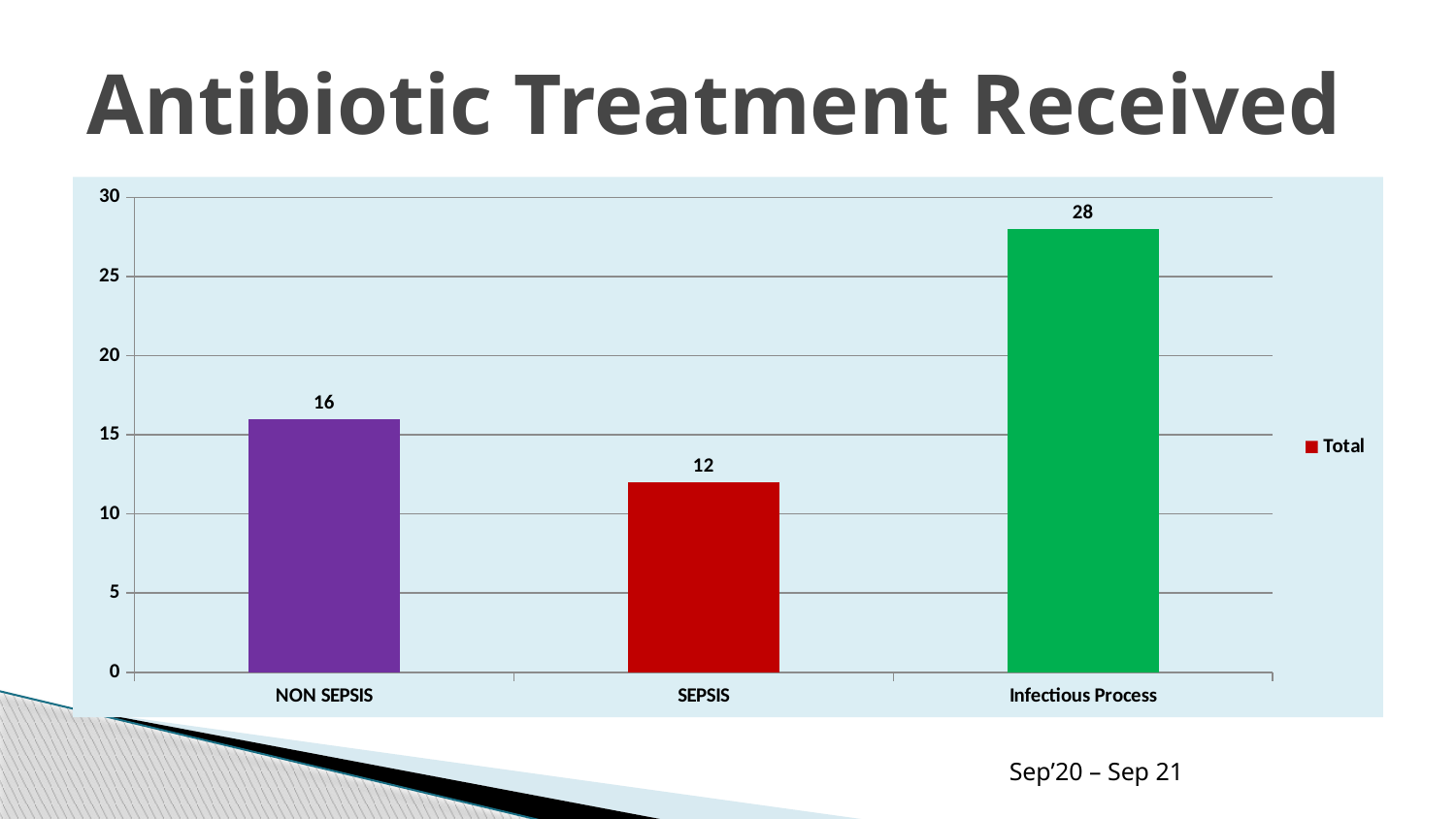
Which category has the lowest value? SEPSIS Which category has the highest value? Infectious Process Which is larger, the value for NON SEPSIS or the value for SEPSIS? NON SEPSIS What is the value for SEPSIS? 12 How many series does the legend list? 1 What kind of chart is shown on the slide? bar chart How many categories are shown on the x axis? 3 Is the value for Infectious Process greater or less than 25? greater What is the value for Infectious Process? 28 What is the difference between the values for Infectious Process and NON SEPSIS? 12 What is the value for NON SEPSIS? 16 What is the difference between the values for NON SEPSIS and SEPSIS? 4